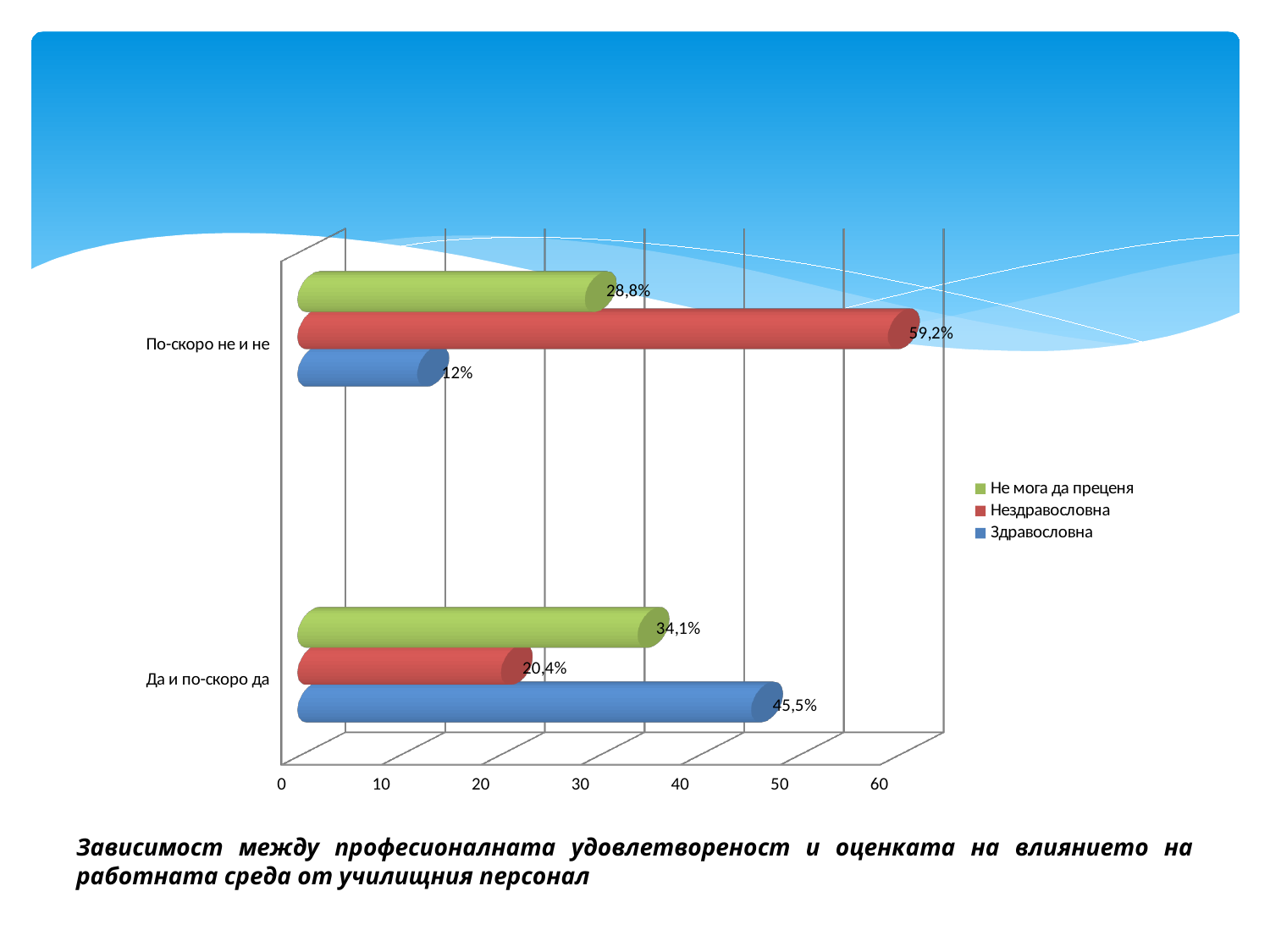
What is the value for Нездравословна in the По-скоро не и не category? 59,2% How many categories are shown on the vertical axis? 2 What is the value for Не мога да преценя in the По-скоро не и не category? 28,8% What kind of chart is shown on the slide? Bar chart How many series does the legend list? 3 What is the value for Здравословна in the Да и по-скоро да category? 45,5% Which is larger: Не мога да преценя for Да и по-скоро да or Не мога да преценя for По-скоро не и не? Да и по-скоро да Which series has the lowest value in the По-скоро не и не category? Здравословна Which colour represents the Нездравословна series? Red What is the value for Здравословна in the По-скоро не и не category? 12% Which series has the highest value in the Да и по-скоро да category? Здравословна What is the difference between the Нездравословна values for По-скоро не и не and Да и по-скоро да? 38,8%